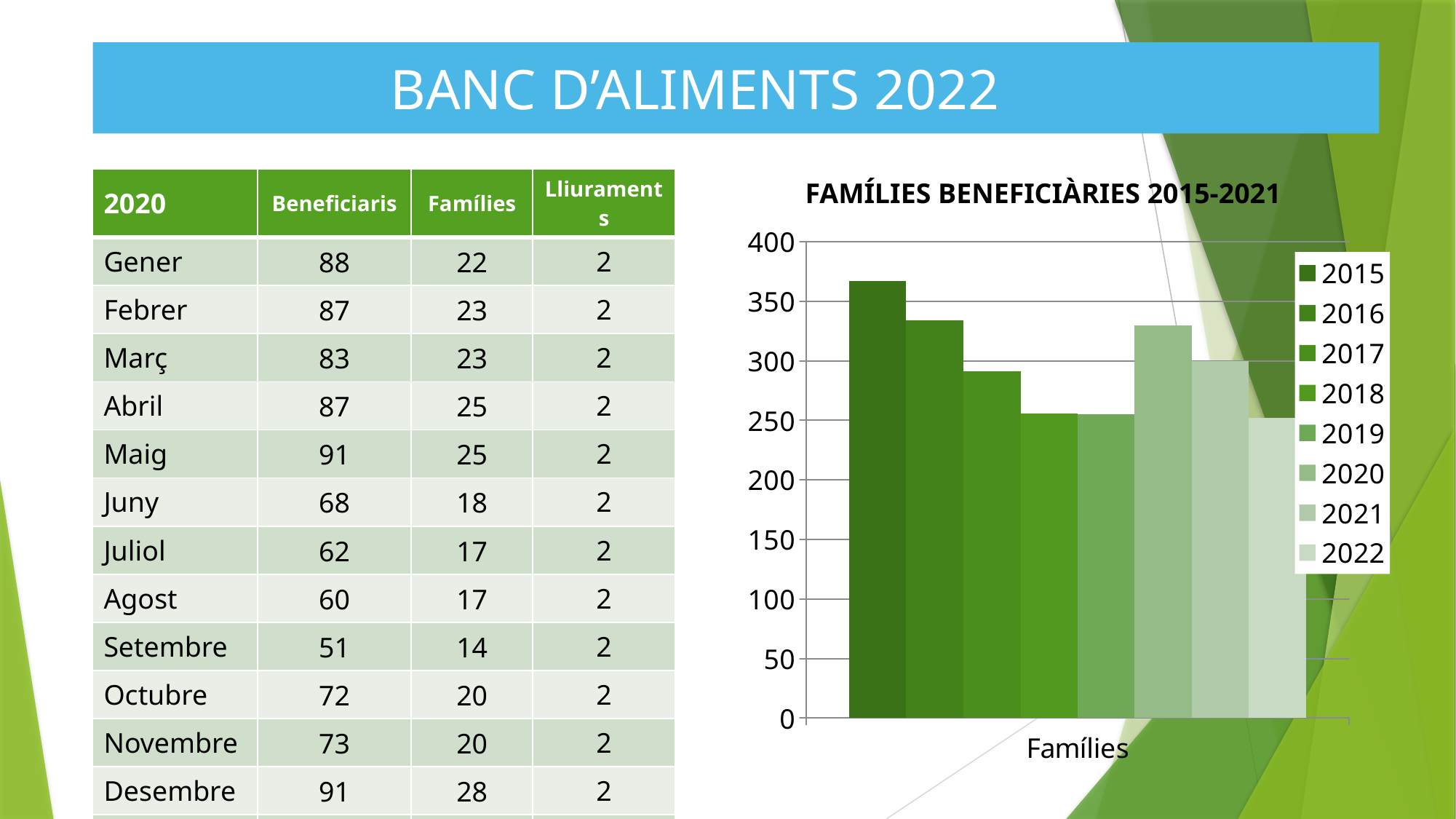
How many series does the chart's legend list? 8 Which is larger in the chart, the bar for 2018 or the bar for 2021? 2021 What kind of chart is shown on the slide? bar chart Which is larger in the chart, the bar for 2015 or the bar for 2016? 2015 Which is larger in the chart, the bar for 2017 or the bar for 2020? 2020 Is the value for 2022 greater or less than 300? less How many categories are shown on the x axis of the chart? 1 Is the value for 2020 greater or less than 300? greater What is the title of the chart? FAMÍLIES BENEFICIÀRIES 2015-2021 Which year has the highest bar in the chart? 2015 Is the value for 2015 greater or less than 350? greater